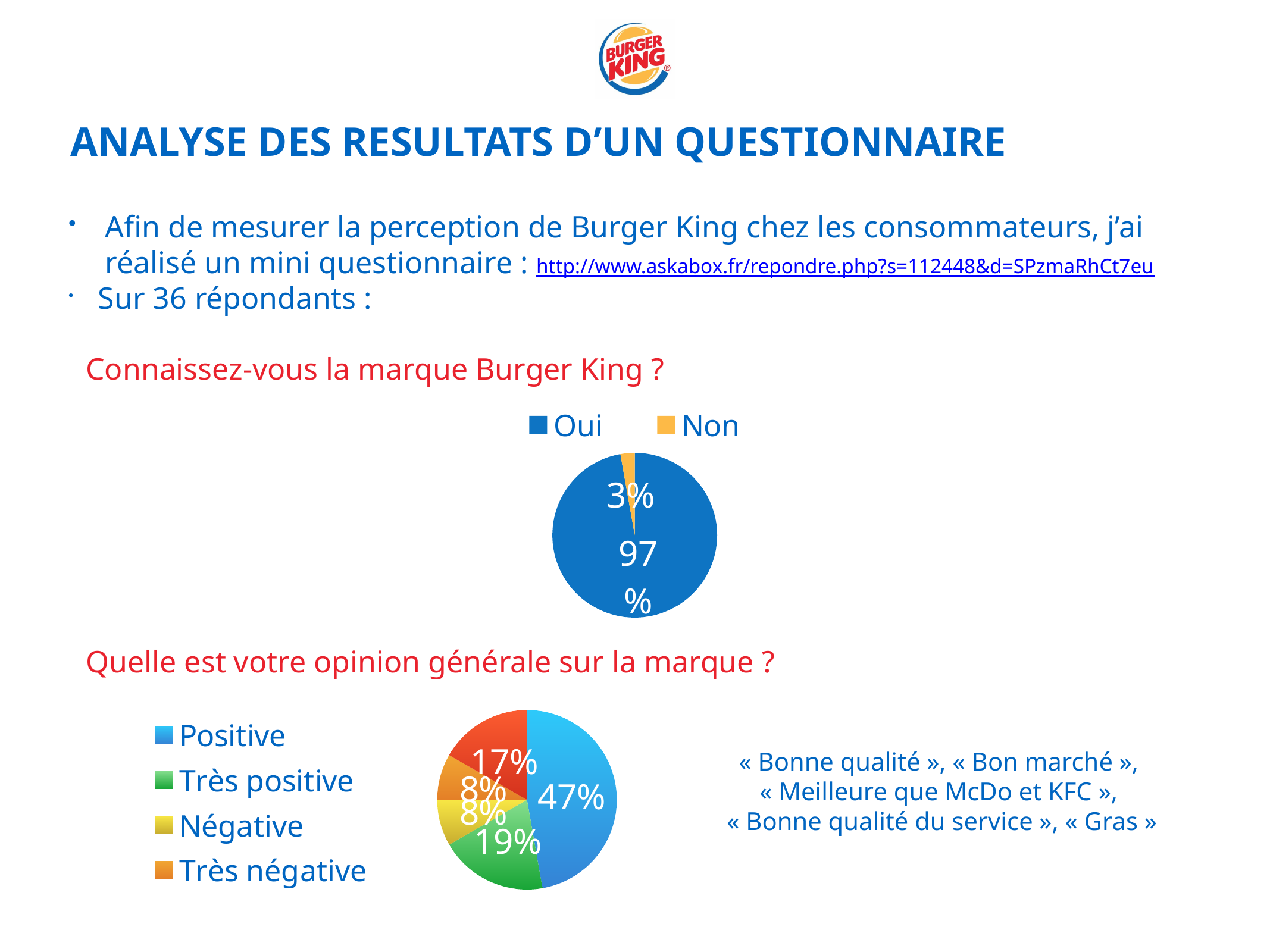
In the pie chart for "Quelle est votre opinion générale sur la marque ?", what share is labelled for Positive? 47% In the pie chart for "Quelle est votre opinion générale sur la marque ?", which opinion has the largest share? Positive How many entries does the legend of the "Connaissez-vous la marque Burger King ?" chart list? 2 In the pie chart for "Connaissez-vous la marque Burger King ?", what is the difference in percentage points between Oui and Non? 94 In the pie chart for "Connaissez-vous la marque Burger King ?", what share of respondents answered Non? 3% In the pie chart for "Connaissez-vous la marque Burger King ?", what share of respondents answered Oui? 97% In the pie chart for "Quelle est votre opinion générale sur la marque ?", which is larger: Positive or Très positive? Positive In the pie chart for "Quelle est votre opinion générale sur la marque ?", what share is labelled for Très positive? 19% What type of chart is used for "Quelle est votre opinion générale sur la marque ?"? Pie chart How many entries does the legend of the "Quelle est votre opinion générale sur la marque ?" chart list? 4 In the pie chart for "Quelle est votre opinion générale sur la marque ?", what is the difference in percentage points between Positive and Très positive? 28 In the pie chart for "Connaissez-vous la marque Burger King ?", which answer has the larger share? Oui